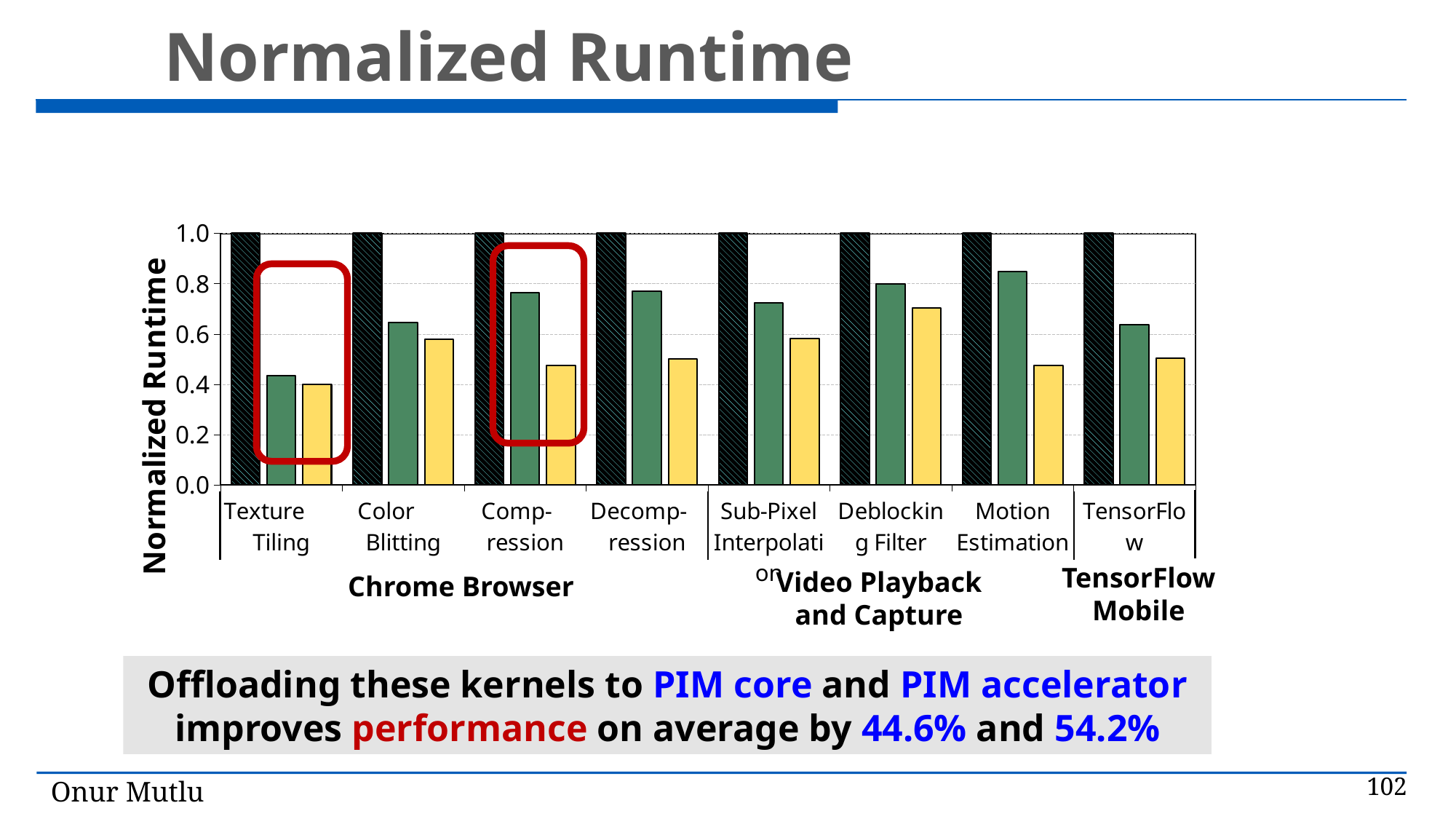
Is the value of the yellow bar for Sub-Pixel Interpolation greater or less than 0.8? less Which kernel has the lowest green bar? Texture Tiling Which is larger, the green bar for Color Blitting or the green bar for Compression? Compression Which kernel has the highest yellow bar? Deblocking Filter What is the value of the black bar for Texture Tiling? 1.0 What is the label of the y axis? Normalized Runtime Is the value of the yellow bar for Deblocking Filter greater or less than 0.6? greater What kind of chart is shown on the slide? bar chart How many kernel categories are shown along the x axis? 8 Is the value of the green bar for Texture Tiling greater or less than 0.6? less How many bars are plotted for each kernel category? 3